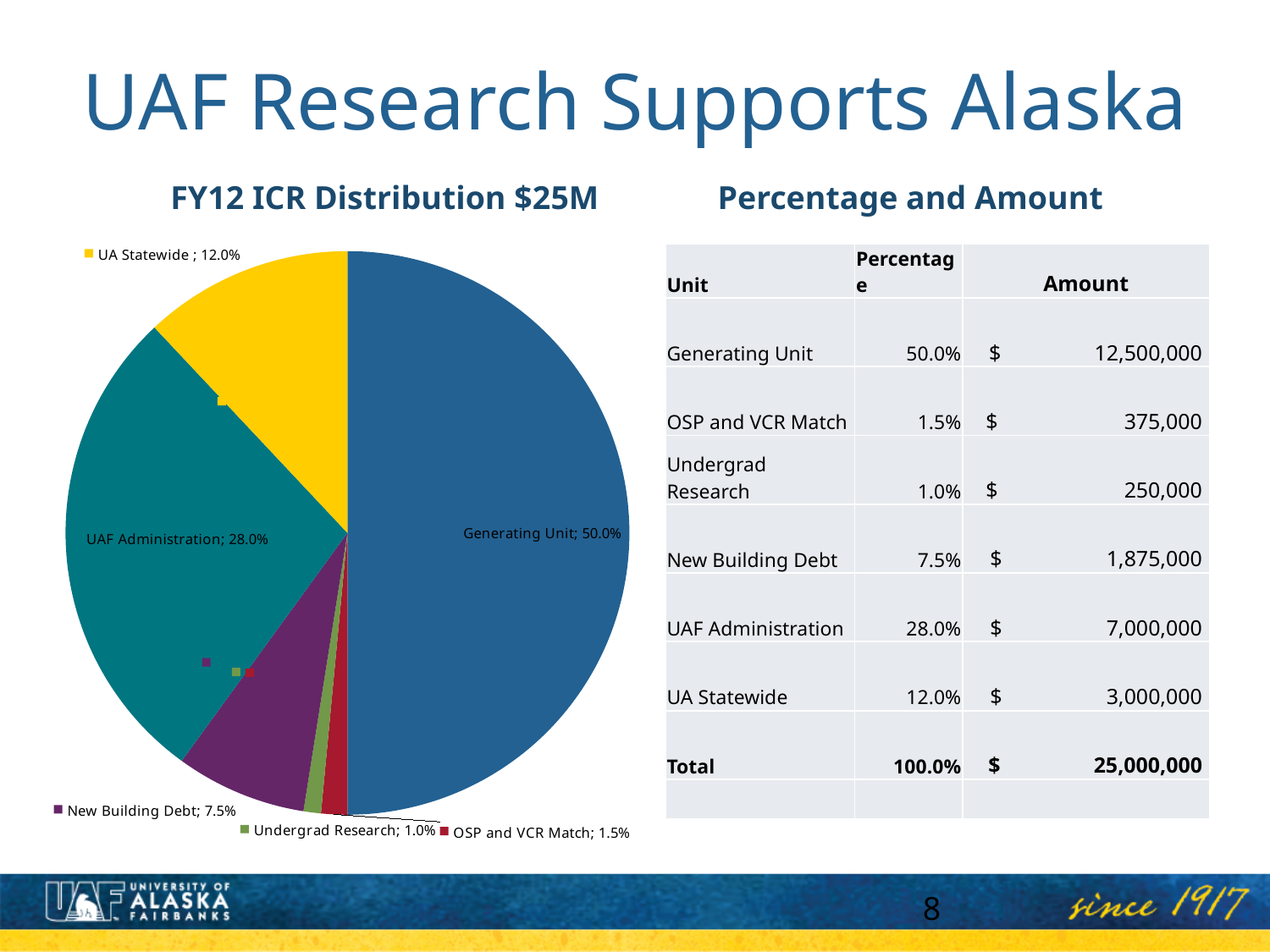
What is the difference between the UAF Administration and UA Statewide shares? 16.0% What is the value shown for UAF Administration? 28.0% What is the value shown for UA Statewide? 12.0% Which category has the largest slice of the pie? Generating Unit Which category has the smallest slice of the pie? Undergrad Research How many categories are shown in the pie chart? 6 What is the title of the chart? FY12 ICR Distribution $25M Which is larger, New Building Debt or OSP and VCR Match? New Building Debt What is the value shown for OSP and VCR Match? 1.5% What type of chart is shown on the slide? pie chart What is the value shown for New Building Debt? 7.5% What share of the pie does Generating Unit represent? 50.0%